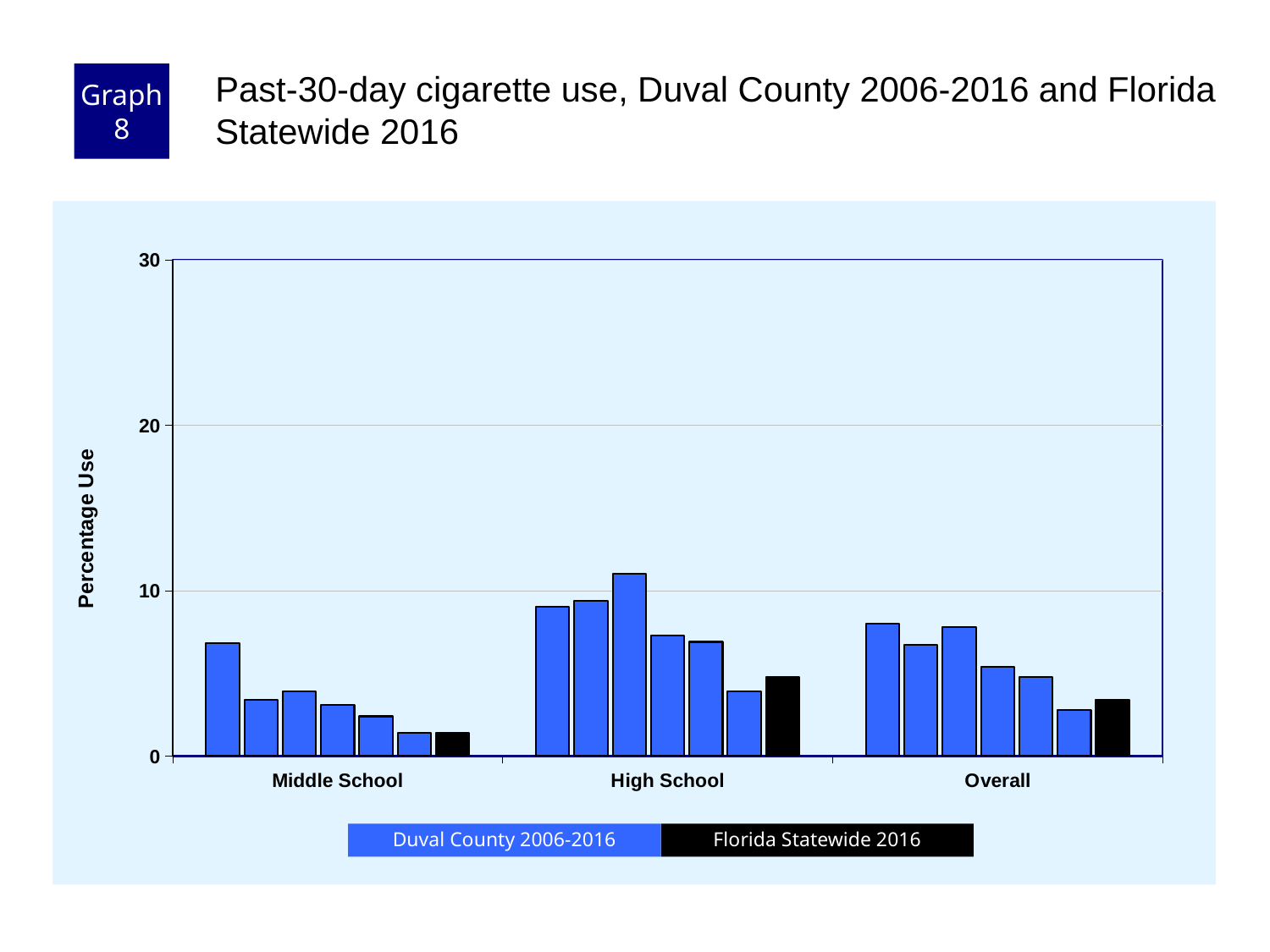
What kind of chart is shown on the slide? bar chart What colour represents Florida Statewide 2016 in the legend? black Within the Middle School group, do the Duval County bars generally rise or fall from left to right? fall What is the label on the y axis? Percentage Use Which is larger, the Florida Statewide 2016 value for High School or for Middle School? High School How many series does the legend list? 2 Is the Florida Statewide 2016 value for High School greater or less than 10? less Which is larger, the Florida Statewide 2016 value for Overall or for Middle School? Overall Is the Florida Statewide 2016 value for Middle School greater or less than 10? less Which category group contains the tallest bar in the chart? High School Is the tallest Duval County bar in the High School group greater or less than 10? greater How many categories are shown on the x axis? 3